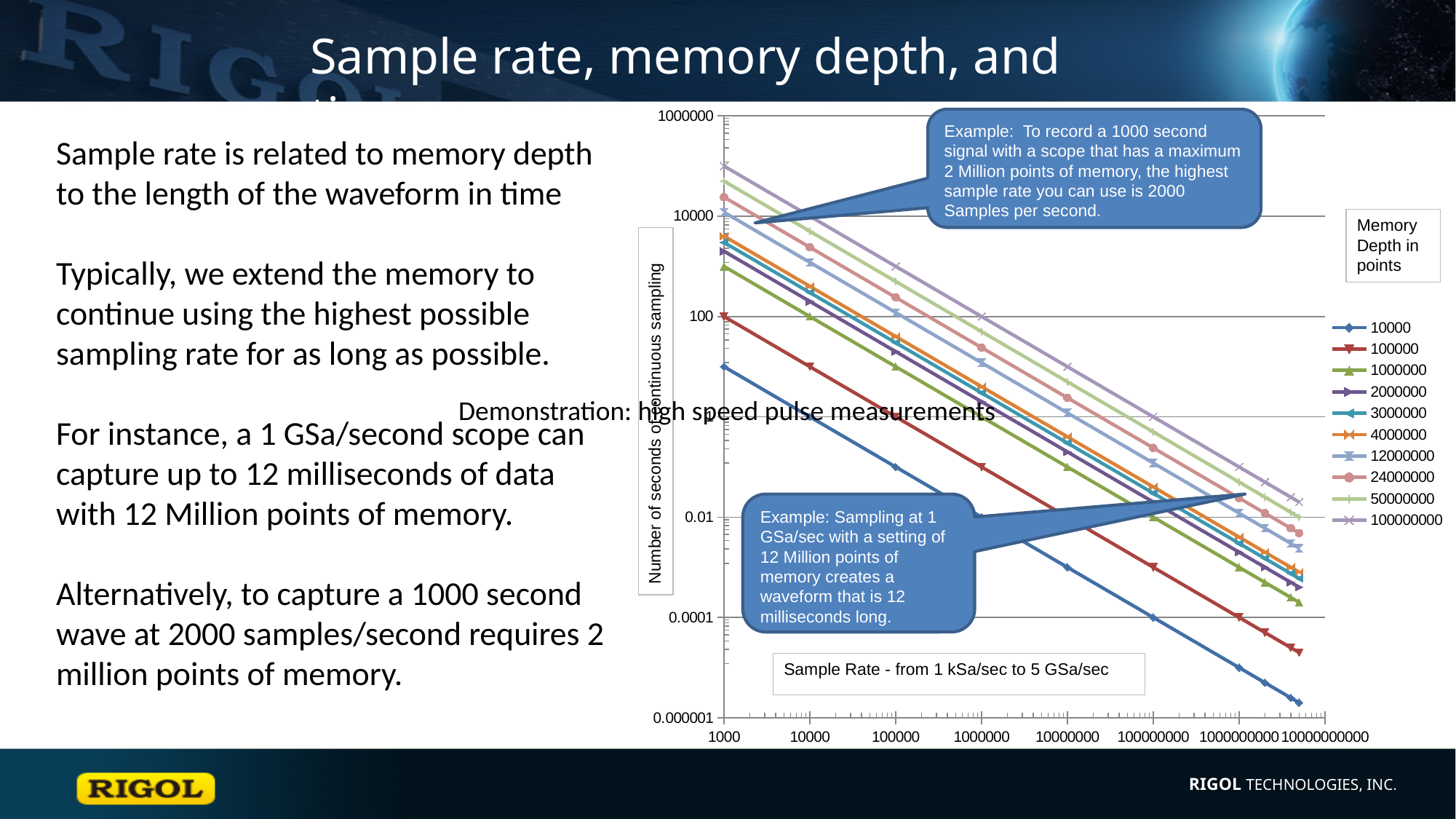
Which memory depth series has the highest number of seconds of continuous sampling at every sample rate? 100000000 What is the title of the chart's legend? Memory Depth in points At a sample rate of 1000, is the value for the 100000000 memory depth series greater or less than 10000? greater Which memory depth series has the lowest number of seconds of continuous sampling at every sample rate? 10000 At a sample rate of 1000, how many seconds of continuous sampling does the 100000 memory depth series give? 100 At a sample rate of 1000000, which series gives more seconds of continuous sampling, 24000000 or 3000000? 24000000 At a sample rate of 1000, is the value for the 10000 memory depth series greater or less than 100? less At a sample rate of 1000000000, is the value for the 10000 memory depth series greater or less than 0.0001? less What kind of chart is shown on the slide? line chart How many series does the chart's legend list? 10 What is the label of the chart's vertical axis? Number of seconds of continuous sampling As the sample rate increases along the x axis, do the seconds of continuous sampling rise or fall? fall